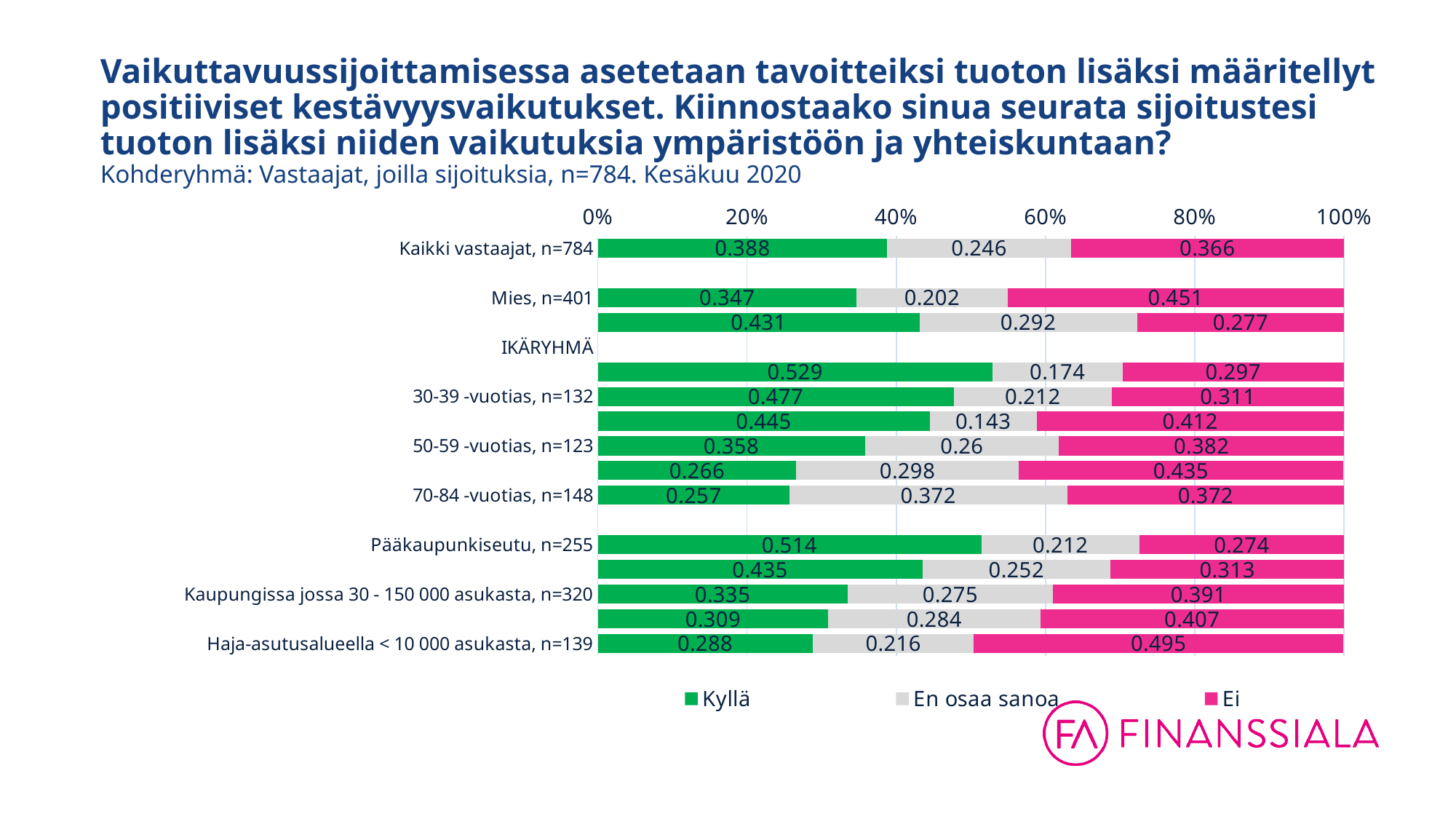
What is the Kyllä value for Pääkaupunkiseutu, n=255? 0.514 Is the Kyllä value for 50-59 -vuotias, n=123 greater or less than 40%? less What is the Ei value for Mies, n=401? 0.451 How many series does the legend list? 3 What is the En osaa sanoa value for 70-84 -vuotias, n=148? 0.372 What is the Ei value for Haja-asutusalueella < 10 000 asukasta, n=139? 0.495 What is the Kyllä value for Kaikki vastaajat, n=784? 0.388 Which has the larger Kyllä value: Pääkaupunkiseutu, n=255 or 30-39 -vuotias, n=132? Pääkaupunkiseutu, n=255 Which has the larger Ei value: Haja-asutusalueella < 10 000 asukasta, n=139 or Kaupungissa jossa 30 - 150 000 asukasta, n=320? Haja-asutusalueella < 10 000 asukasta, n=139 What is the En osaa sanoa value for Kaupungissa jossa 30 - 150 000 asukasta, n=320? 0.275 For Mies, n=401, how much larger is the Ei value than the Kyllä value? 0.104 What kind of chart is shown on the slide? Stacked bar chart